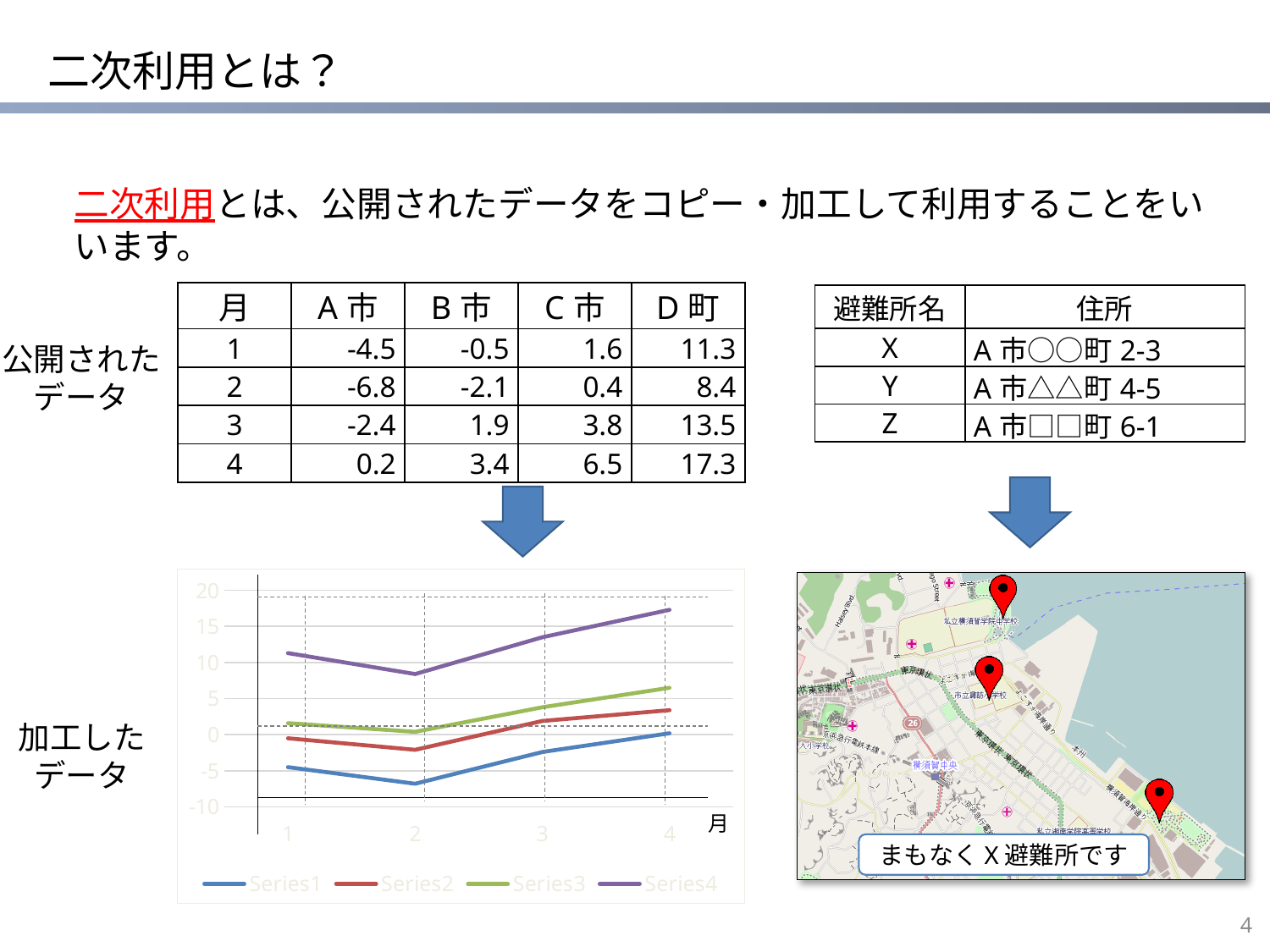
In the line chart, which series has the highest value at month 4? Series4 In the line chart, does Series3 rise or fall from month 2 to month 4? rise What is the label on the x axis of the line chart? 月 In the line chart, does Series1 rise or fall from month 1 to month 2? fall In the line chart, is the value of Series4 at month 4 greater or less than 15? greater What kind of chart is shown on the lower left of the slide? line chart How many points along the x axis (月) does each series in the line chart have? 4 In the line chart, is the value of Series1 at month 2 greater or less than -5? less In the line chart, which series has the lowest value at month 2? Series1 In the line chart, is the value of Series4 at month 1 greater or less than 10? greater In the line chart, which is larger at month 4: Series2 or Series3? Series3 How many series does the legend of the line chart list? 4